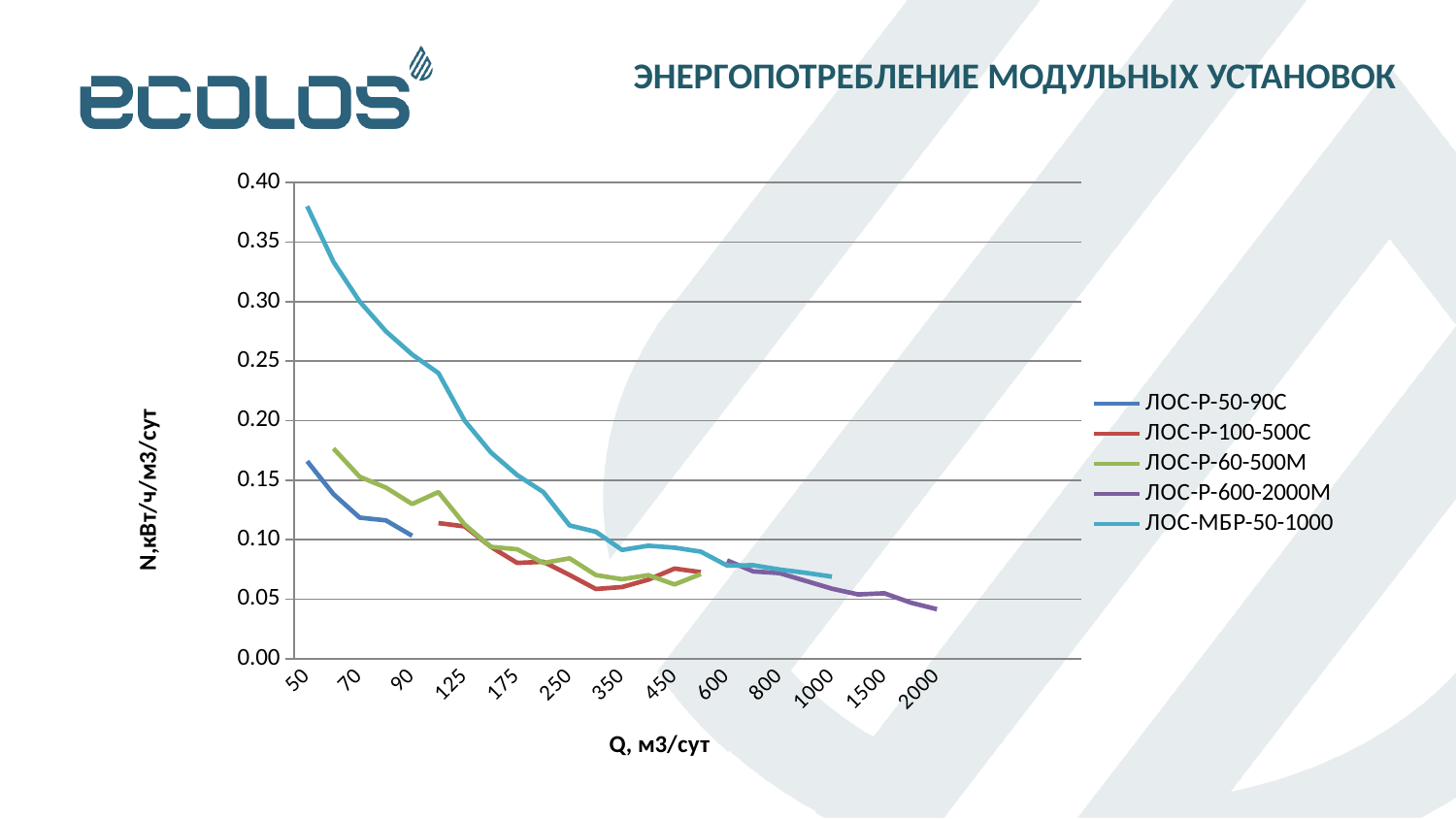
Is the value for ЛОС-Р-50-90С at Q = 50 greater or less than 0.15? greater Is the value for ЛОС-МБР-50-1000 at Q = 50 greater or less than 0.35? greater Which series extends to the largest Q value on the chart? ЛОС-Р-600-2000М What is the title of the slide's chart? ЭНЕРГОПОТРЕБЛЕНИЕ МОДУЛЬНЫХ УСТАНОВОК What is the label of the vertical axis? N,кВт/ч/м3/сут Is the value for ЛОС-Р-600-2000М at Q = 2000 greater or less than 0.05? less Which series reaches the highest value on the chart? ЛОС-МБР-50-1000 Do the values of the ЛОС-МБР-50-1000 series rise or fall as Q increases? fall What kind of chart is shown on the slide? line chart How many tick labels are shown on the horizontal (Q) axis? 13 At Q = 50, which series has the larger value: ЛОС-МБР-50-1000 or ЛОС-Р-50-90С? ЛОС-МБР-50-1000 How many series does the legend list? 5